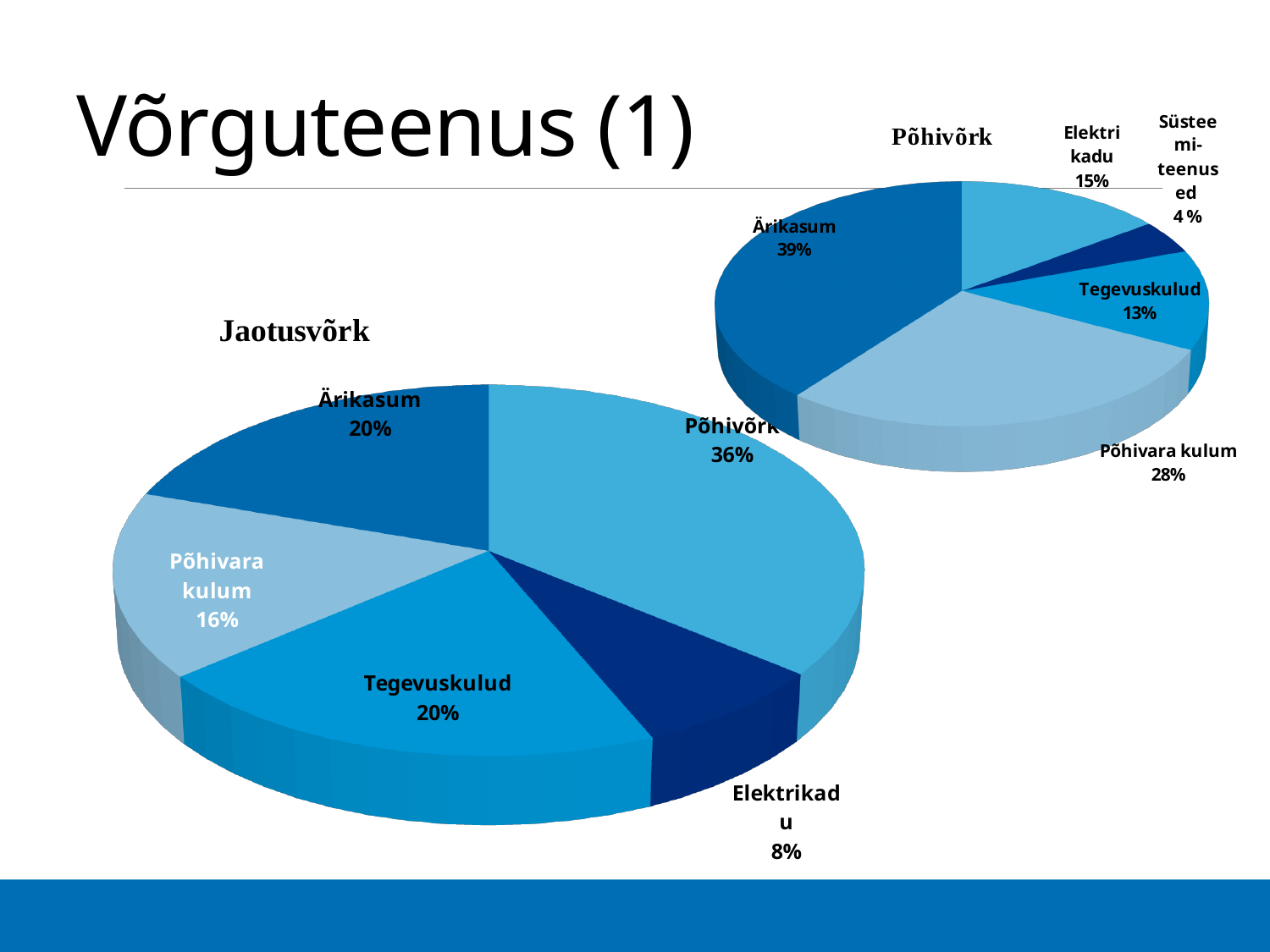
In the Jaotusvõrk chart, which slice is the largest? Põhivõrk In the Põhivõrk chart, what share does Tegevuskulud have? 13% In the Jaotusvõrk chart, which slice is the smallest? Elektrikadu In the Jaotusvõrk chart, what share does Põhivara kulum have? 16% In the Põhivõrk chart, what share does Ärikasum have? 39% In the Jaotusvõrk chart, what share does Elektrikadu have? 8% In the Jaotusvõrk chart, what share does Põhivõrk have? 36% In the Põhivõrk chart, which is larger, Elektrikadu or Tegevuskulud? Elektrikadu What kind of charts are shown on the slide? Pie charts In the Põhivõrk chart, which slice is the smallest? Süsteemiteenused In the Põhivõrk chart, what is the difference between the Põhivara kulum share and the Elektrikadu share? 13% In the Jaotusvõrk chart, how many slices does the pie have? 5